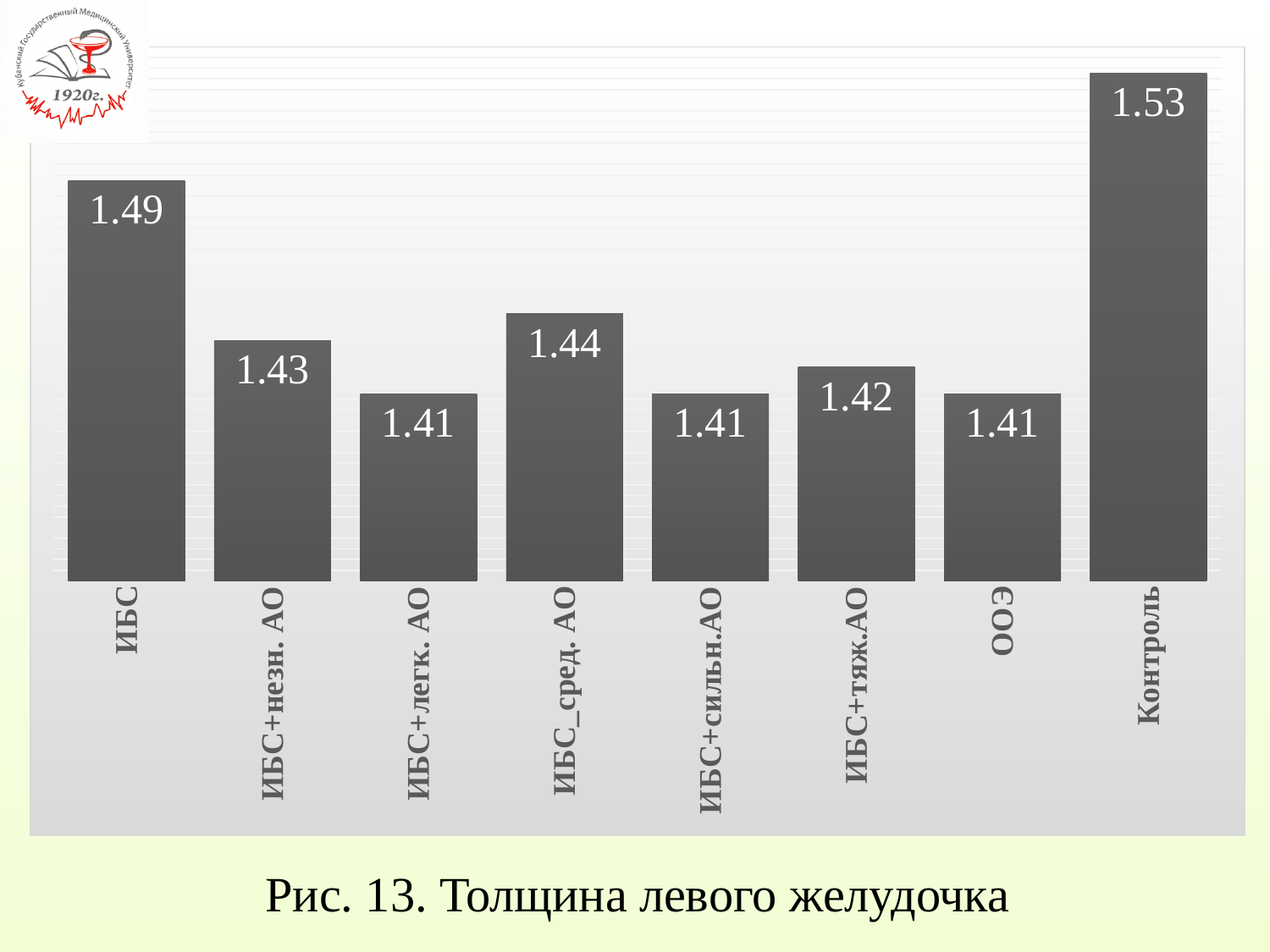
How many categories are shown in the chart? 8 What kind of chart is shown on the slide? Bar chart What is the value for Контроль? 1.53 What is the value for ИБС? 1.49 Which category has the highest value? Контроль What is the value for ИБС_сред. АО? 1.44 What is the difference between the values for Контроль and ИБС? 0.04 Which is larger, the value for ИБС or the value for ИБС+незн. АО? ИБС What is the caption of the figure on the slide? Рис. 13. Толщина левого желудочка Which is larger, the value for ИБС_сред. АО or the value for ИБС+сильн.АО? ИБС_сред. АО What is the difference between the values for ИБС+незн. АО and ИБС+легк. АО? 0.02 What is the value for ИБС+тяж.АО? 1.42